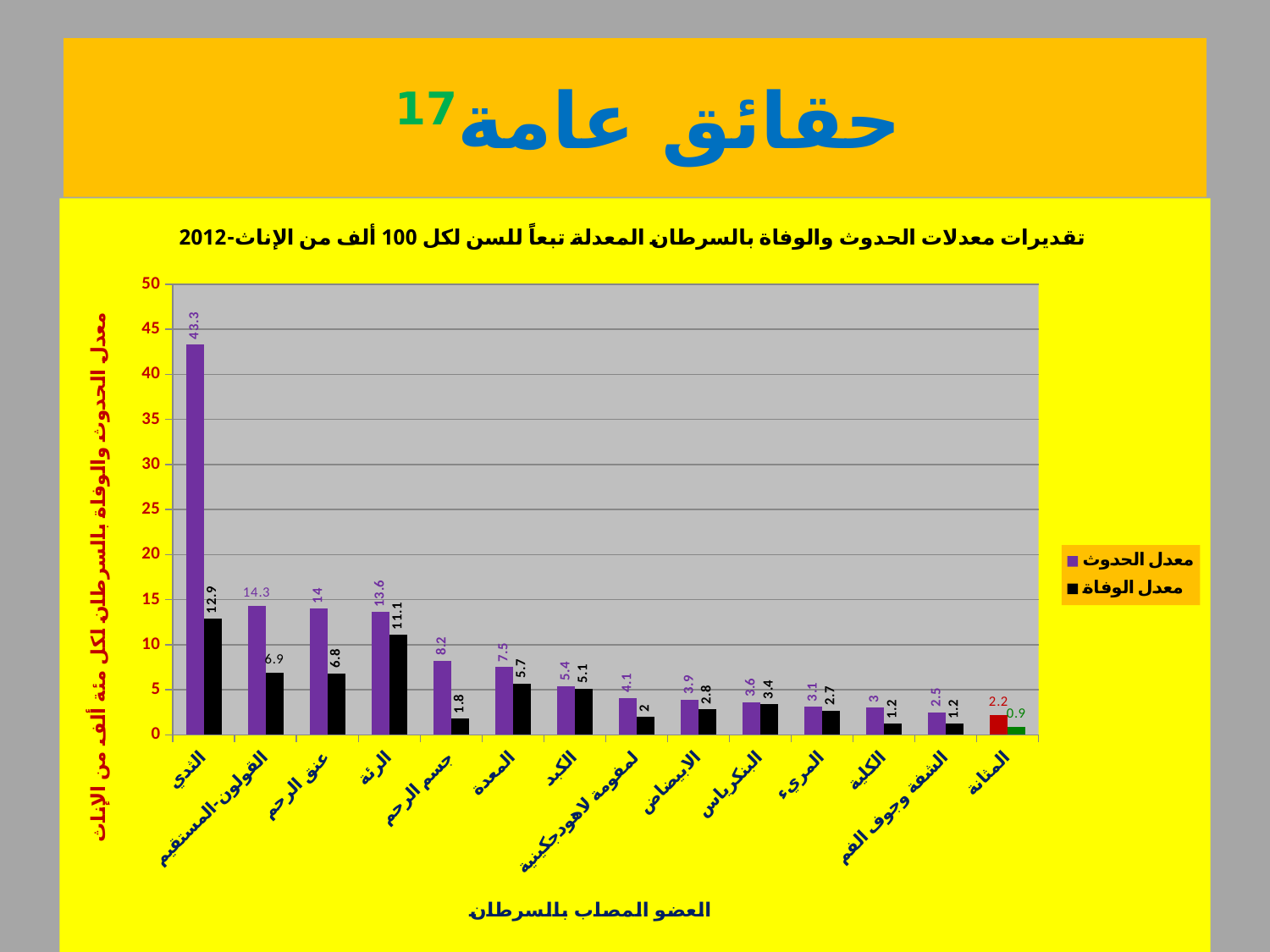
How many series does the legend list? 2 What type of chart is shown on the slide? bar chart Which category has the lowest معدل الوفاة? المثانة What is the value of معدل الحدوث for الثدي? 43.3 Which category has the highest معدل الحدوث? الثدي Is the value of معدل الحدوث for جسم الرحم greater or less than 10? less What is the value of معدل الحدوث for القولون-المستقيم? 14.3 How many categories (organs) are shown on the x axis? 14 Which is larger: معدل الوفاة for الرئة or معدل الوفاة for القولون-المستقيم? الرئة What is the difference between معدل الحدوث and معدل الوفاة for الثدي? 30.4 What is the value of معدل الوفاة for الرئة? 11.1 Which colour represents معدل الوفاة in the chart? black